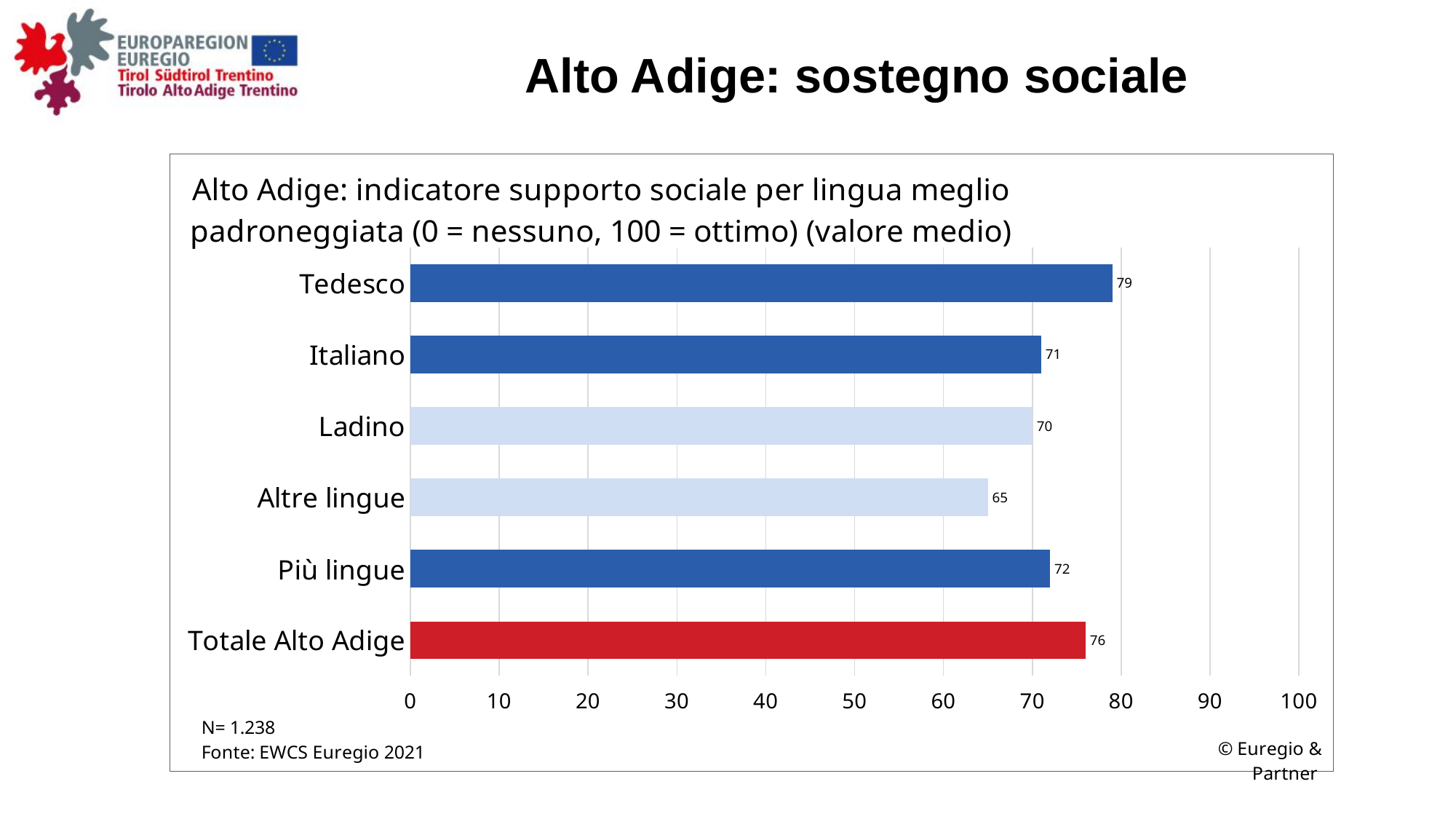
Is the value for Italiano greater or less than 80? less How many categories are shown in the chart? 6 What is the value shown for Altre lingue? 65 What is the difference between the values for Totale Alto Adige and Altre lingue? 11 Which has a higher value, Più lingue or Ladino? Più lingue What is the social support indicator value for Tedesco? 79 What is the difference between the values for Tedesco and Italiano? 8 What type of chart is shown on the slide? Bar chart Which language group has the lowest social support indicator value? Altre lingue What colour is the bar for Totale Alto Adige? Red Which language group has the highest social support indicator value? Tedesco What is the value for Totale Alto Adige? 76